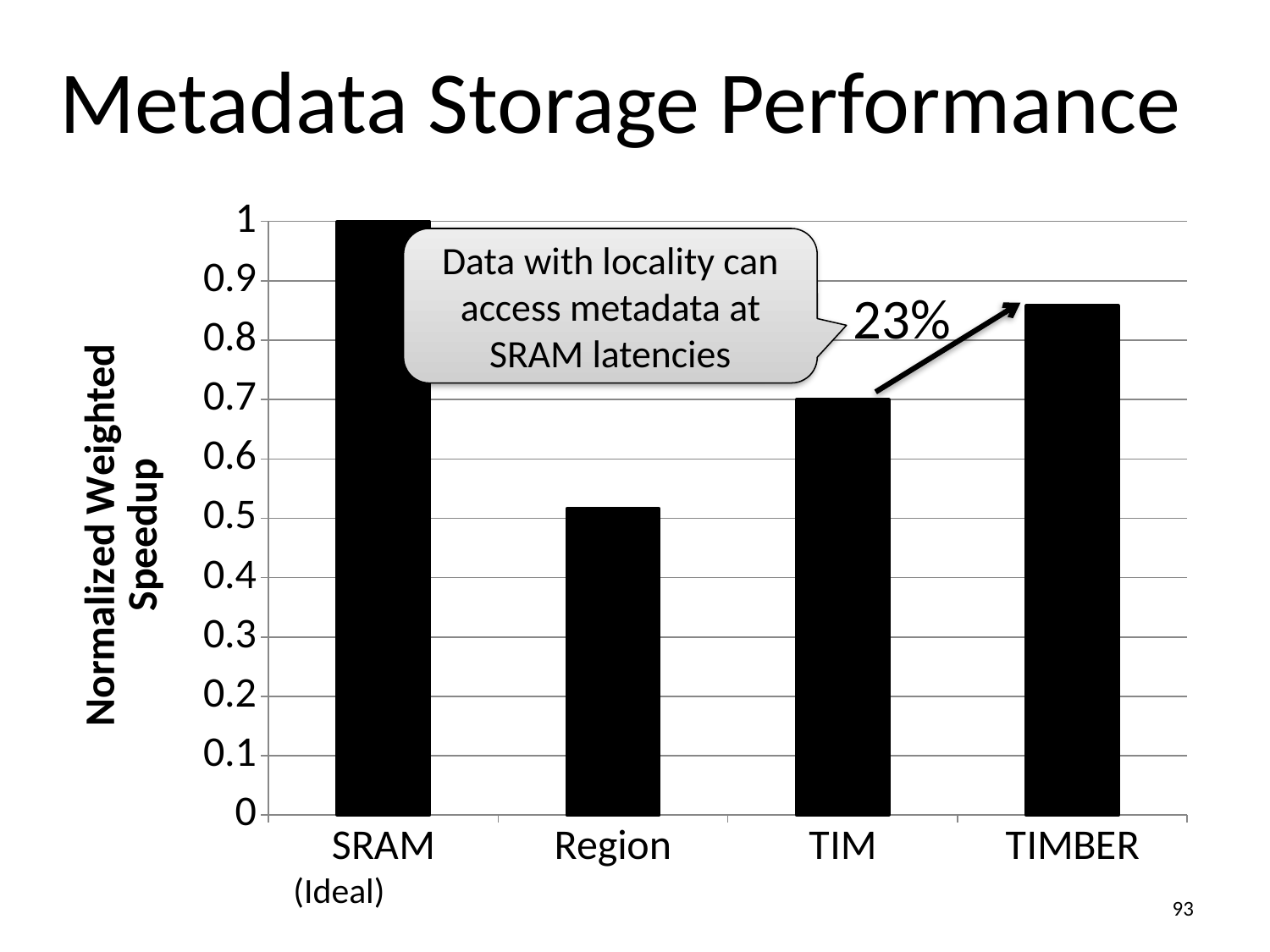
Which has a higher normalized weighted speedup, TIM or TIMBER? TIMBER Which category has the lowest normalized weighted speedup? Region Which category has the highest normalized weighted speedup? SRAM (Ideal) Is the value for TIM greater or less than 0.6? greater What kind of chart is shown on the slide? bar chart Is the value for TIMBER greater or less than 0.8? greater How many categories are plotted on the x axis? 4 Which has a higher normalized weighted speedup, Region or TIM? TIM What is the normalized weighted speedup for SRAM (Ideal)? 1 Is the value for Region greater or less than 0.6? less What is the label of the y axis? Normalized Weighted Speedup What percentage improvement is annotated between TIM and TIMBER? 23%